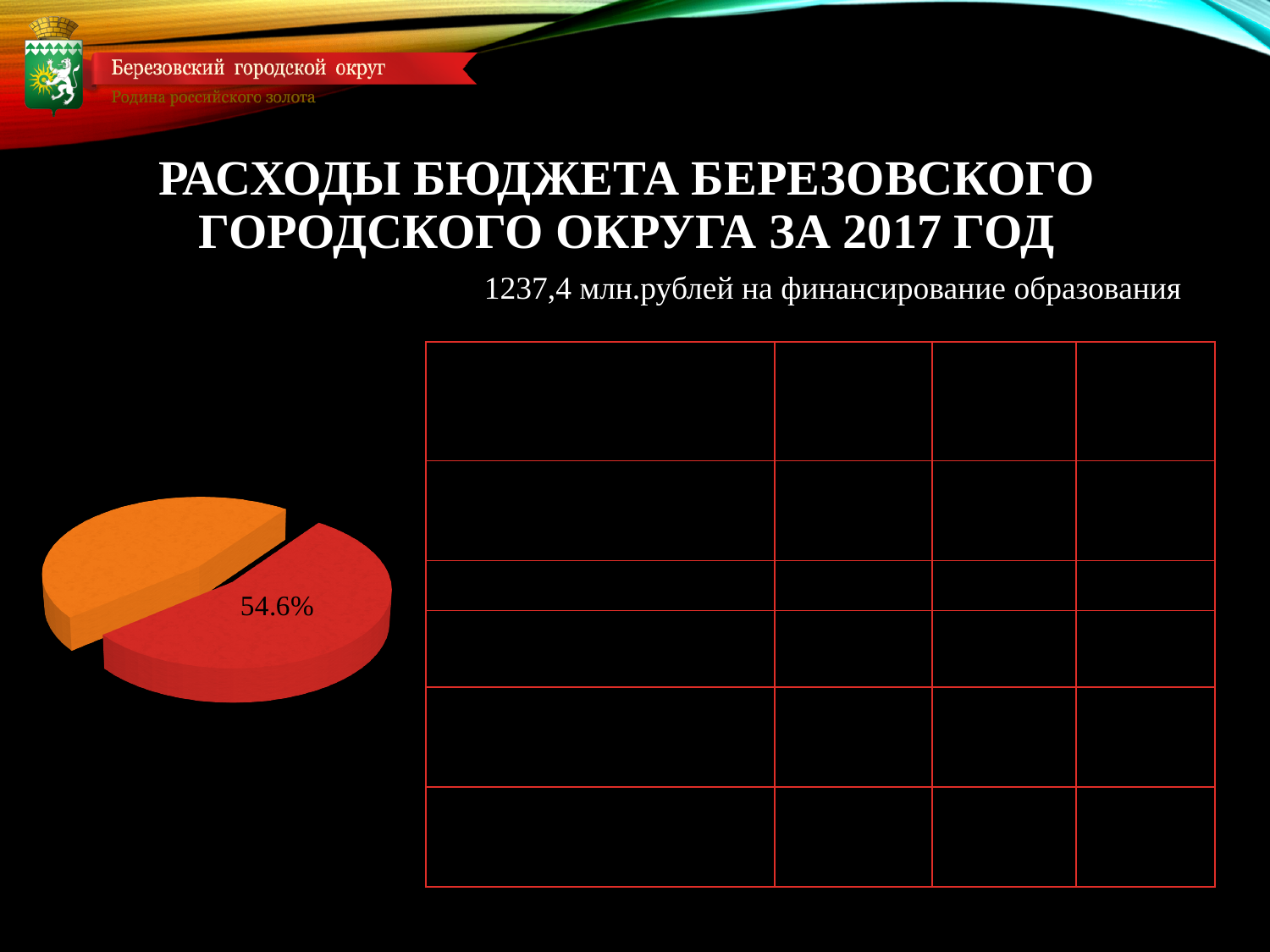
Which slice of the pie chart carries a data label? the red slice How many slices does the pie chart have? 2 What share of the pie does the red slice represent? 54.6% What percentage is printed on the red slice of the pie chart? 54.6% Which slice of the pie chart is the largest? the red slice What kind of chart is shown on the left of the slide? pie chart Which slice is larger, the red slice or the orange slice? the red slice What two colours are used for the slices of the pie chart? red and orange Is the share of the orange slice greater or less than 50%? less Is the share of the red slice greater or less than 50%? greater Which slice of the pie chart is the smallest? the orange slice